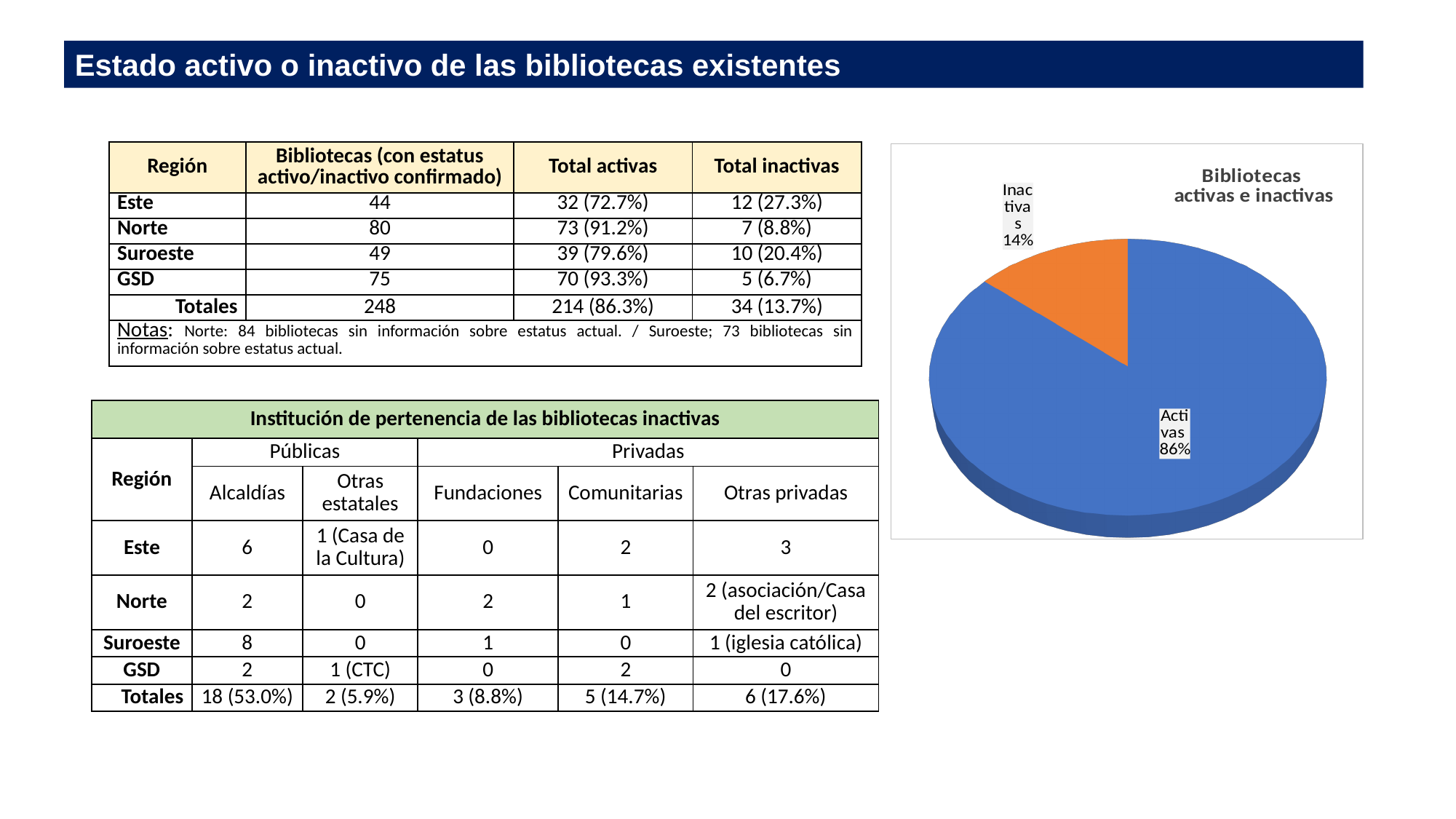
Which slice of the pie chart is the smallest? Inactivas What is the title of the chart on the slide? Bibliotecas activas e inactivas What kind of chart is shown on the slide? pie chart What colour is the Activas slice in the pie chart? blue Is the share for Inactivas greater or less than 50%? less Which is larger in the pie chart, Activas or Inactivas? Activas What share of the pie does the Activas slice represent? 86% Which slice of the pie chart is the largest? Activas What share of the pie does the Inactivas slice represent? 14% What is the difference in percentage points between the Activas and Inactivas slices? 72 How many slices does the pie chart have? 2